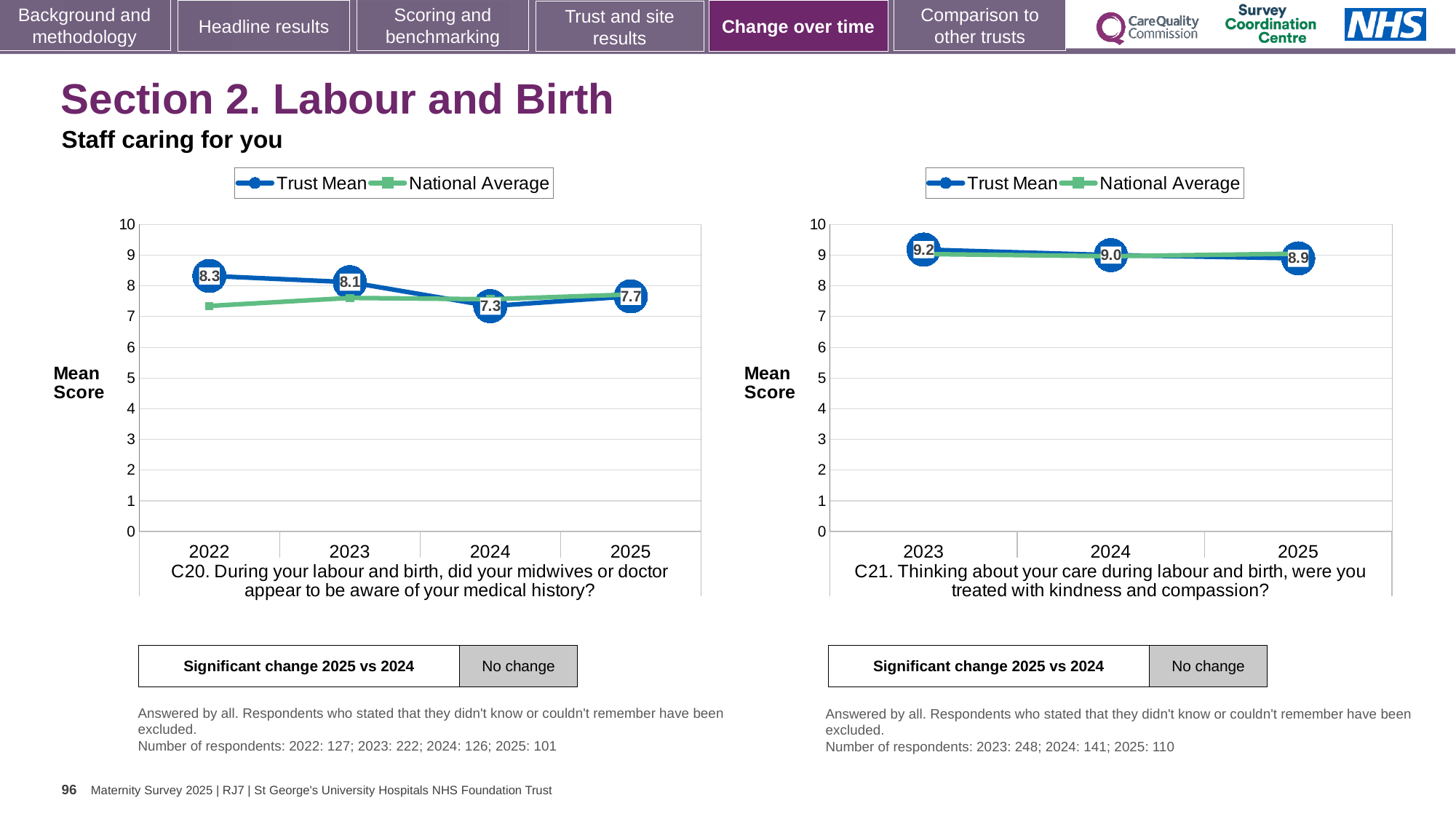
In the C21 chart (right), what is the Trust Mean score for 2023? 9.2 In the C20 chart (left), is the Trust Mean score for 2025 greater or less than the Trust Mean score for 2024? greater In the C21 chart (right), what is the Trust Mean score for 2025? 8.9 In the C21 chart (right), what is the difference between the Trust Mean scores for 2023 and 2025? 0.3 In the C20 chart (left), which year has the highest Trust Mean score? 2022 How many years are plotted on the x axis of the C21 chart (right)? 3 In the C20 chart (left), which year has the lowest Trust Mean score? 2024 What type of chart is the C21 chart (right)? Line chart In the C20 chart (left), what is the Trust Mean score for 2022? 8.3 In the C20 chart (left), what is the difference between the Trust Mean scores for 2022 and 2024? 1.0 In the C20 chart (left), what is the Trust Mean score for 2024? 7.3 How many series does the legend of the C20 chart (left) list? 2